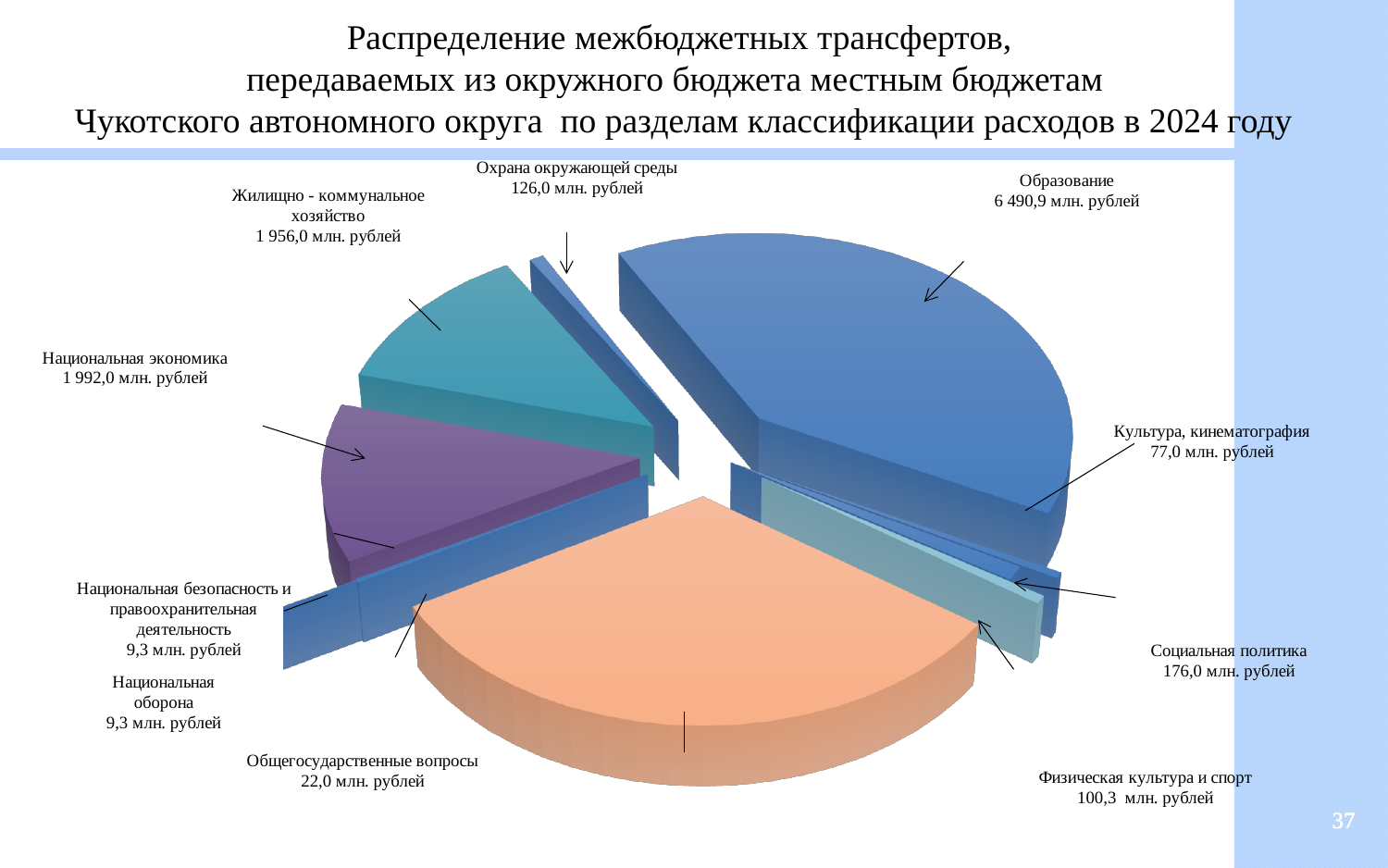
What is the value for Образование? 6 490,9 млн. рублей Which category has the highest value? Образование What is the difference between Социальная политика and Охрана окружающей среды? 50,0 млн. рублей What is the difference between Национальная экономика and Жилищно-коммунальное хозяйство? 36,0 млн. рублей What type of chart is shown on the slide? Pie chart What is the value for Национальная экономика? 1 992,0 млн. рублей What is the value for Социальная политика? 176,0 млн. рублей What is the value for Жилищно-коммунальное хозяйство? 1 956,0 млн. рублей For which year does the chart show the distribution of inter-budget transfers? 2024 Which is larger: Физическая культура и спорт or Культура, кинематография? Физическая культура и спорт What is the value for Физическая культура и спорт? 100,3 млн. рублей